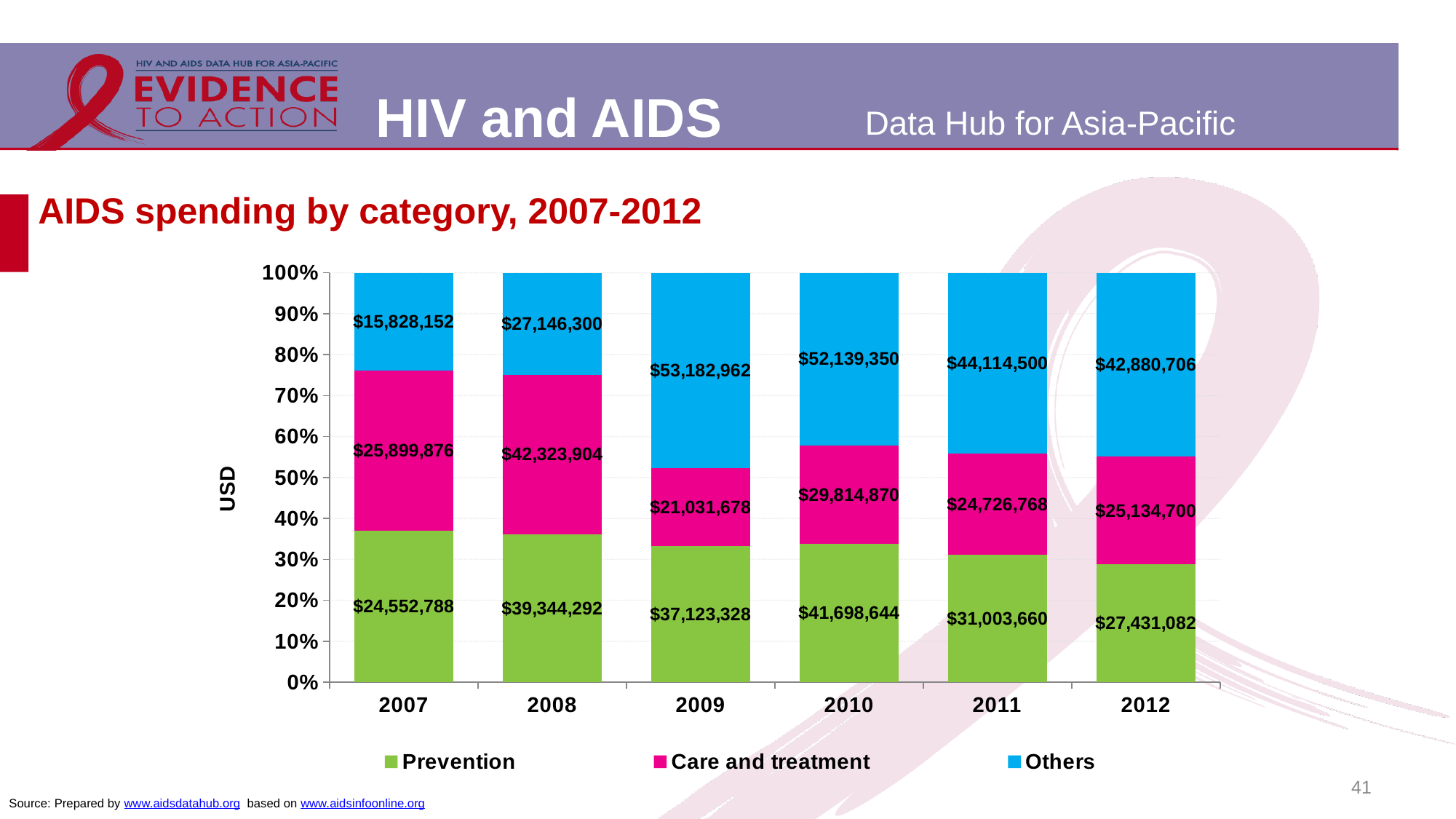
What is the difference between the Others value and the Prevention value in 2010? $10,440,706 What is the Others spending value shown for 2009? $53,182,962 How many series does the legend list? 3 In 2012, which is larger: the Prevention value or the Care and treatment value? Prevention What is the Care and treatment spending value shown for 2012? $25,134,700 What kind of chart is shown on the slide? Stacked bar chart Is the Prevention share of the 2009 bar greater or less than 40%? less In which year is the Others value the lowest? 2007 In which year is the Care and treatment value the highest? 2008 What is the Prevention spending value shown for 2010? $41,698,644 What is the total spending across all three categories in 2007? $66,280,816 How many years are shown on the x axis? 6